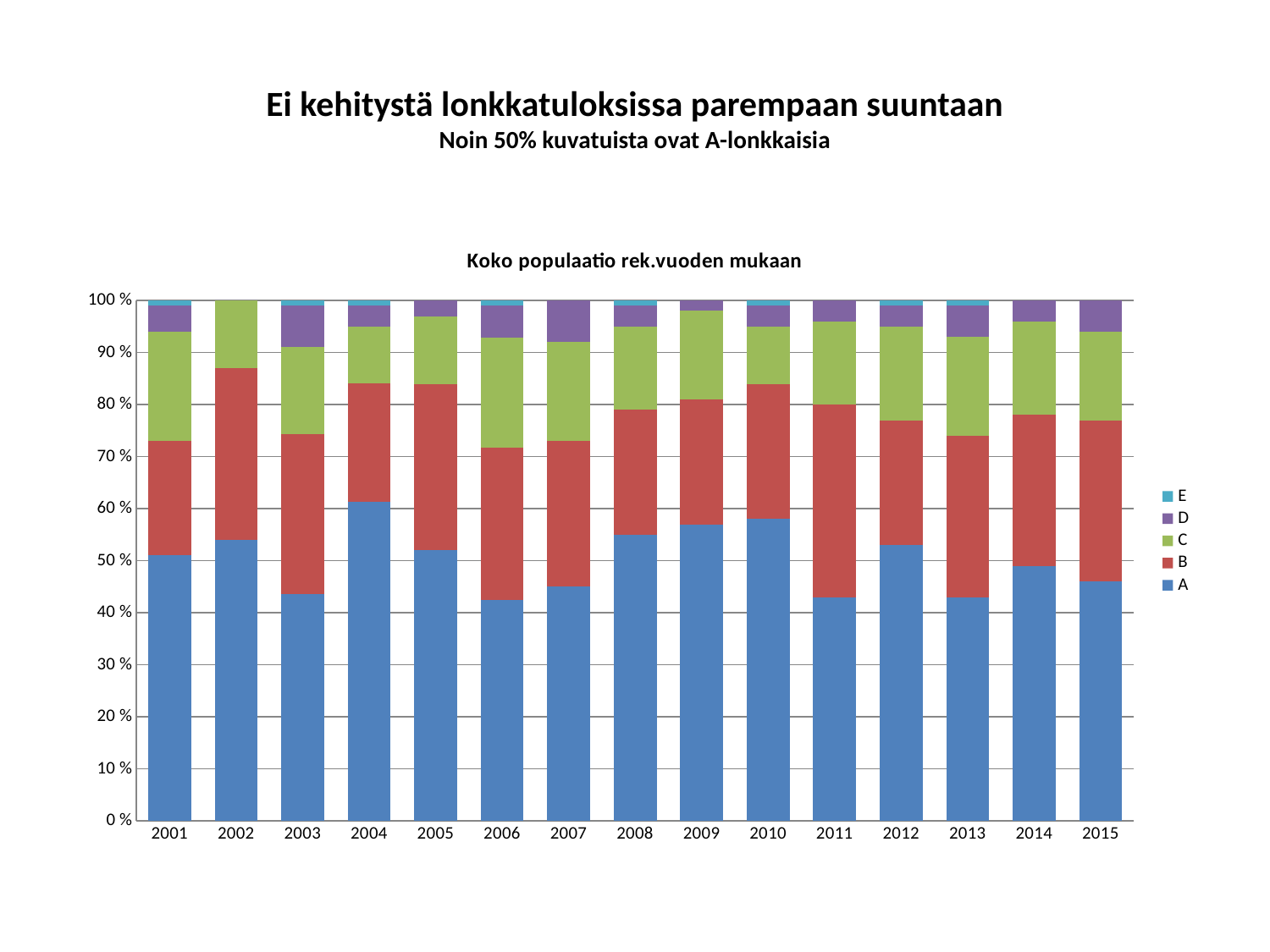
How many series does the legend list? 5 Which colour represents series A in the legend? Blue Which is larger, the share for series A in 2004 or in 2006? 2004 Which year has the largest share for series A? 2004 Is the share for series A in 2009 greater or less than 50 %? greater What kind of chart is shown on the slide? Stacked bar chart Is the share for series A in 2004 greater or less than 50 %? greater How many years are shown on the x axis? 15 What is the total of the stacked bar for 2001? 100 % Is the share for series A in 2006 greater or less than 50 %? less What is the title of the chart? Koko populaatio rek.vuoden mukaan